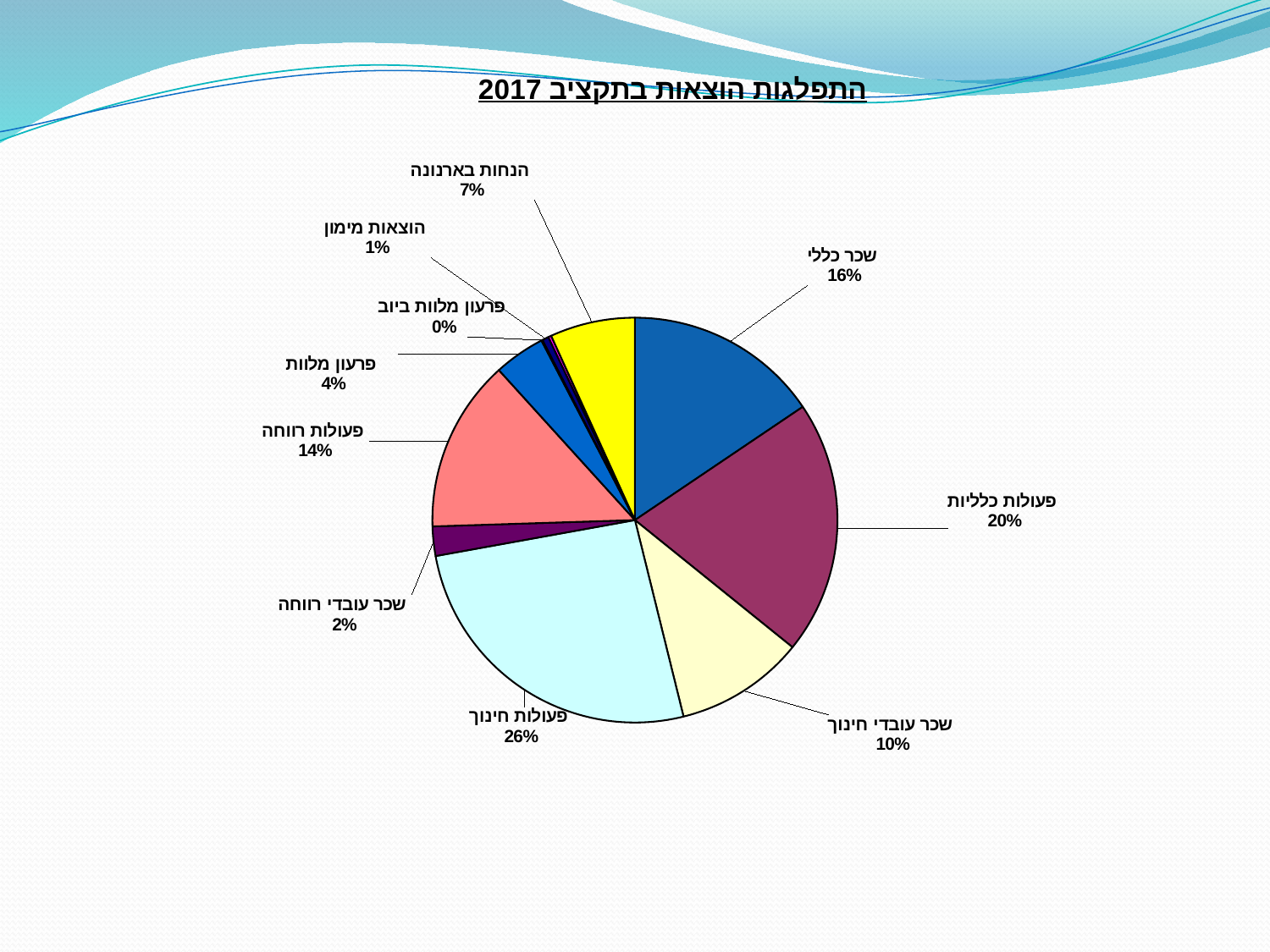
What is the combined percentage of שכר עובדי רווחה and הוצאות מימון? 3% Which category has the largest slice of the pie? פעולות חינוך How many categories are shown in the pie chart? 11 What is the difference in percentage points between פעולות חינוך and שכר עובדי חינוך? 16 What percentage is shown for פעולות כלליות? 20% What percentage is shown for הנחות בארנונה? 7% What share of the budget is פעולות חינוך? 26% What type of chart is shown on the slide? pie chart Which is larger, פעולות רווחה or פרעון מלוות? פעולות רווחה What is the title of the chart? התפלגות הוצאות בתקציב 2017 What percentage is shown for שכר כללי? 16% Which category has the smallest slice of the pie? פרעון מלוות ביוב